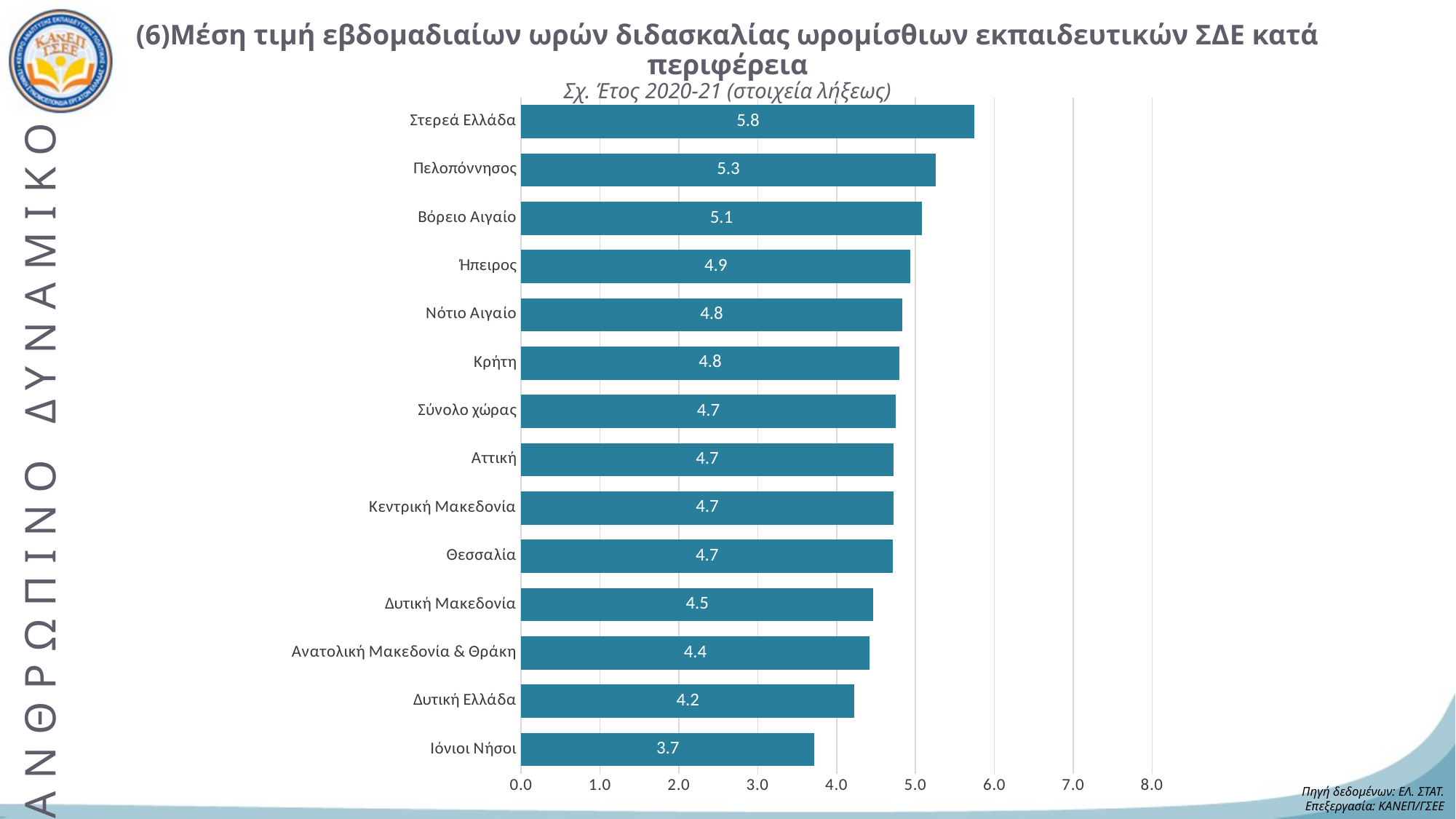
Which region has the lowest value? Ιόνιοι Νήσοι What is the value for Στερεά Ελλάδα? 5.8 What is the value for Σύνολο χώρας? 4.7 Is the value for Βόρειο Αιγαίο greater or less than 5.0? greater What is the value for Δυτική Μακεδονία? 4.5 What kind of chart is shown on the slide? bar chart What is the value for Ιόνιοι Νήσοι? 3.7 How many categories are shown on the chart? 14 What school year does the chart subtitle refer to? 2020-21 Which region has the highest value? Στερεά Ελλάδα Which is larger, the value for Πελοπόννησος or the value for Δυτική Ελλάδα? Πελοπόννησος What is the difference between the values for Στερεά Ελλάδα and Ιόνιοι Νήσοι? 2.1